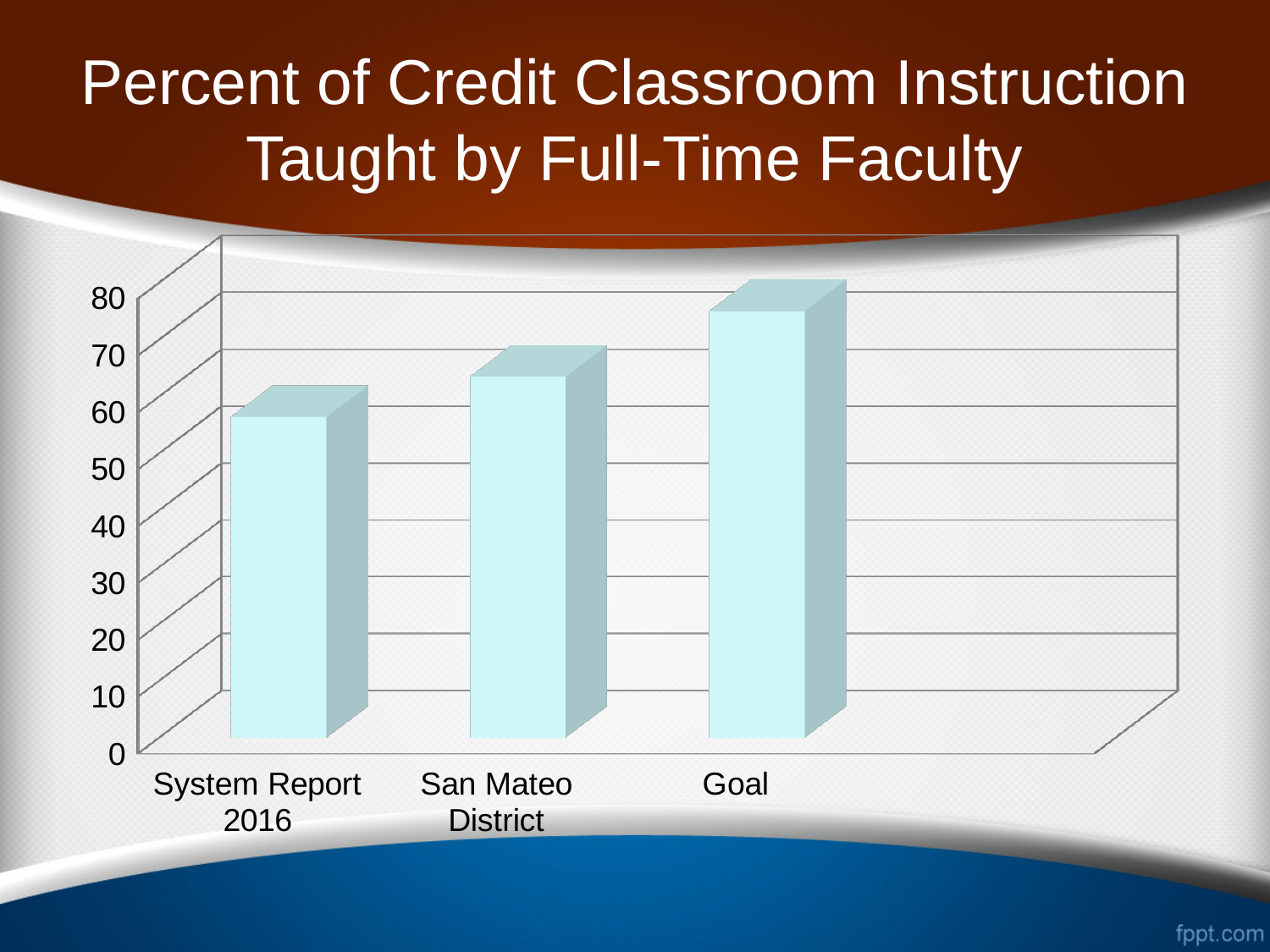
Which is larger, the value for San Mateo District or the value for System Report 2016? San Mateo District Is the value for San Mateo District greater or less than 70? less Do the values rise or fall moving from left to right across the categories? rise Which is larger, the value for Goal or the value for San Mateo District? Goal What kind of chart is shown on the slide? bar chart Is the value for System Report 2016 greater or less than 50? greater Which category has the lowest value? System Report 2016 Which category has the highest value? Goal What is the highest value shown on the vertical axis? 80 What is the title of the slide containing the chart? Percent of Credit Classroom Instruction Taught by Full-Time Faculty Is the value for Goal greater or less than 70? greater How many categories are plotted in the chart? 3